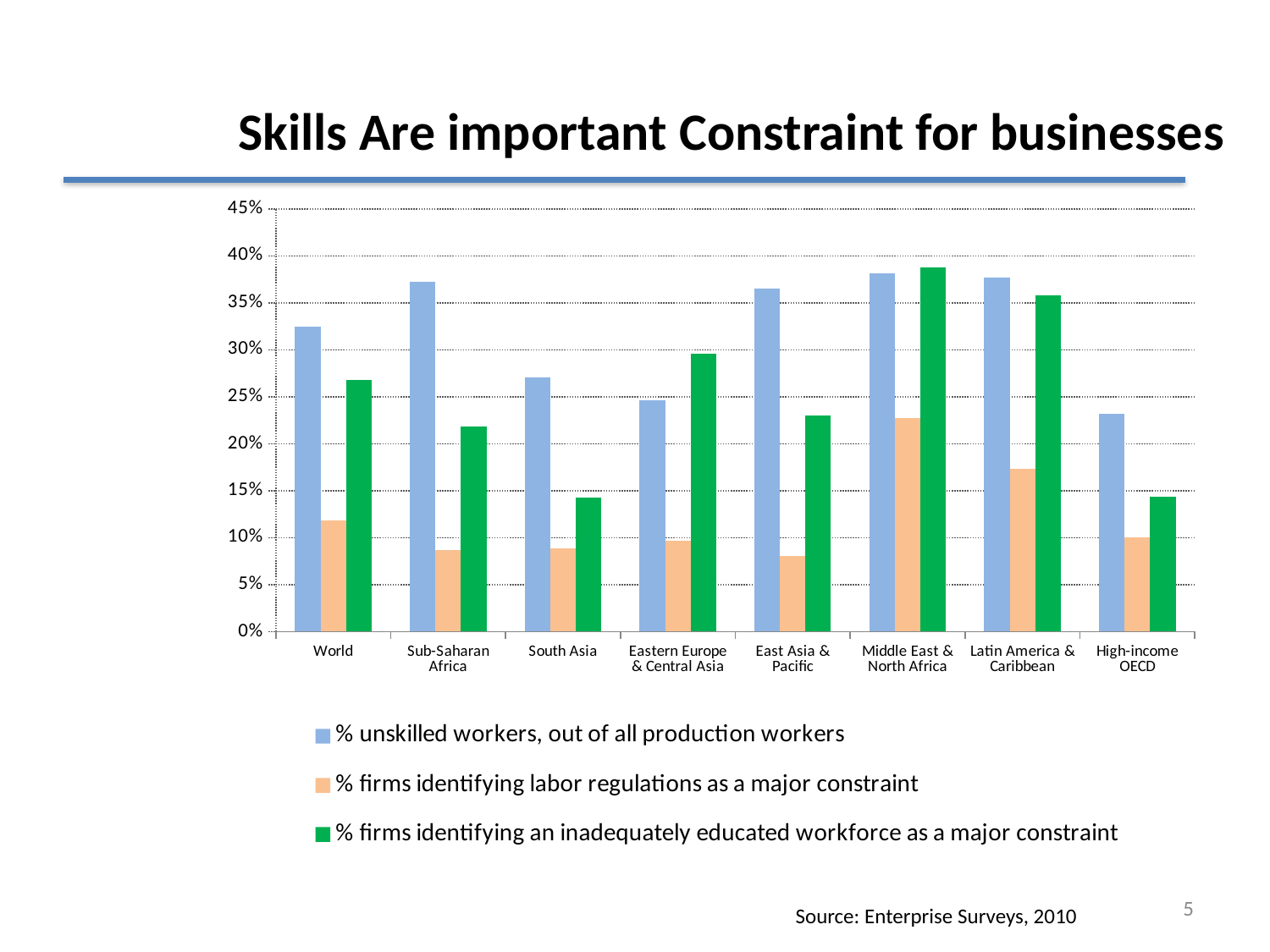
How many series does the legend list? 3 What source is cited for the chart data? Enterprise Surveys, 2010 Which region has the highest value for '% firms identifying labor regulations as a major constraint'? Middle East & North Africa What kind of chart is shown on the slide? bar chart Is the value for '% unskilled workers, out of all production workers' in Sub-Saharan Africa greater or less than 35%? greater For Eastern Europe & Central Asia, which is larger: '% unskilled workers, out of all production workers' or '% firms identifying an inadequately educated workforce as a major constraint'? % firms identifying an inadequately educated workforce as a major constraint For World, which is larger: '% unskilled workers, out of all production workers' or '% firms identifying an inadequately educated workforce as a major constraint'? % unskilled workers, out of all production workers Which region has the highest value for '% firms identifying an inadequately educated workforce as a major constraint'? Middle East & North Africa How many regions (categories) are shown on the x axis? 8 Is the value for '% firms identifying labor regulations as a major constraint' in Middle East & North Africa greater or less than 20%? greater Is the value for '% firms identifying an inadequately educated workforce as a major constraint' in South Asia greater or less than 15%? less